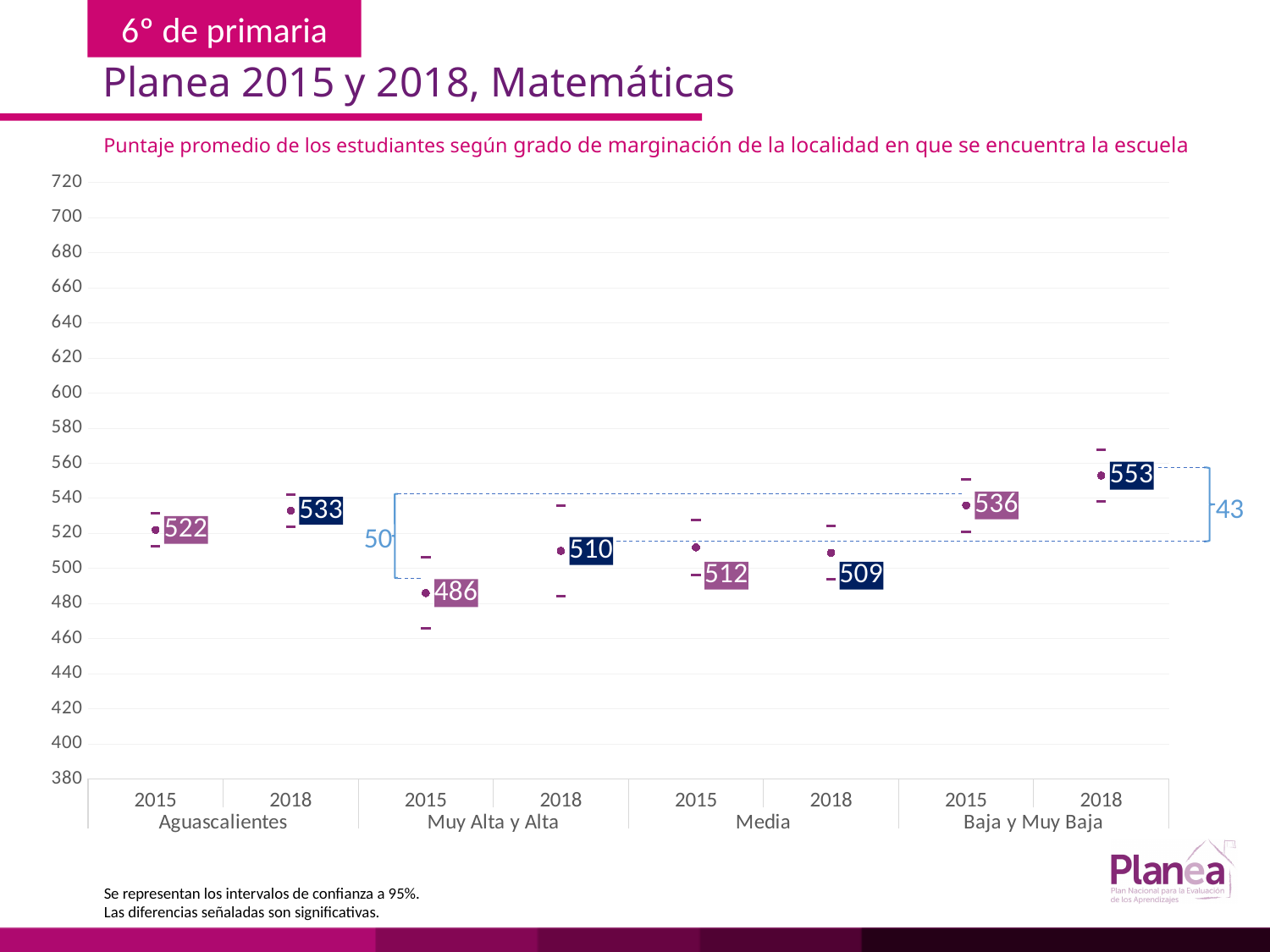
What is the 2018 average score for the Muy Alta y Alta marginación group? 510 What is the difference between the 2018 and 2015 scores for Aguascalientes? 11 Which is larger, the 2015 score for the Media group or the 2018 score for the Media group? 2015 (512) Which group and year has the lowest average score on the chart? Muy Alta y Alta, 2015 Which group and year has the highest average score on the chart? Baja y Muy Baja, 2018 What is the lowest value shown on the vertical axis? 380 What is the 2015 average score for Aguascalientes? 522 What is the 2015 average score for the Media group? 512 What is the 2018 average score for the Baja y Muy Baja group? 553 Did the average score for the Muy Alta y Alta group rise or fall from 2015 to 2018? rise How many data points are plotted on the chart? 8 What is the difference between the 2015 scores of the Baja y Muy Baja group and the Muy Alta y Alta group? 50